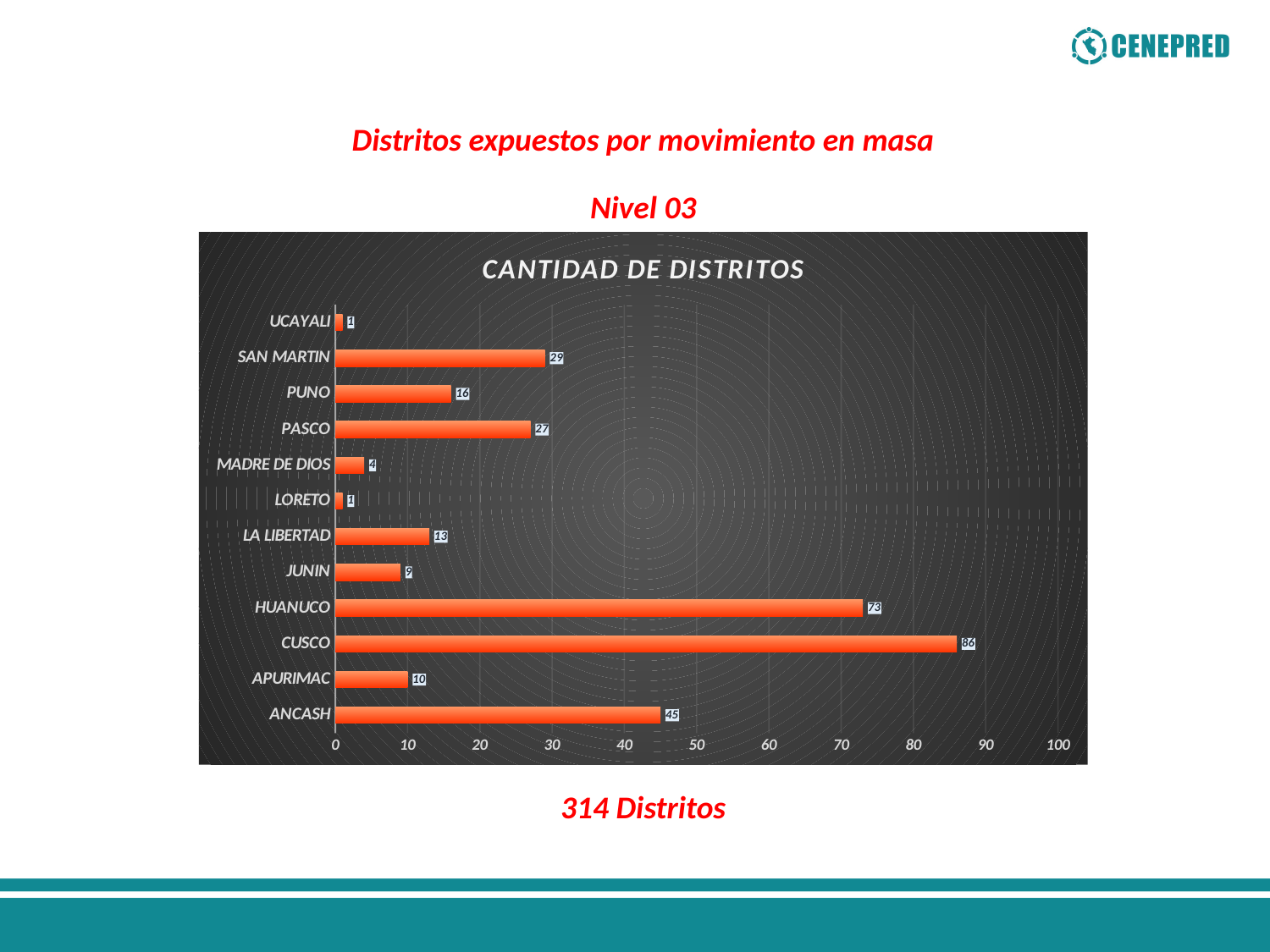
What kind of chart is shown? bar chart What colour are the bars in the chart? orange What is the title of the chart? CANTIDAD DE DISTRITOS What is the value for MADRE DE DIOS? 4 What is the difference between the values for SAN MARTIN and PASCO? 2 What is the difference between the values for CUSCO and HUANUCO? 13 What is the value for CUSCO? 86 How many categories are shown in the chart? 12 Which category has the highest value? CUSCO Is the value for ANCASH greater or less than 40? greater What is the value for SAN MARTIN? 29 Which is larger, the value for PASCO or the value for PUNO? PASCO